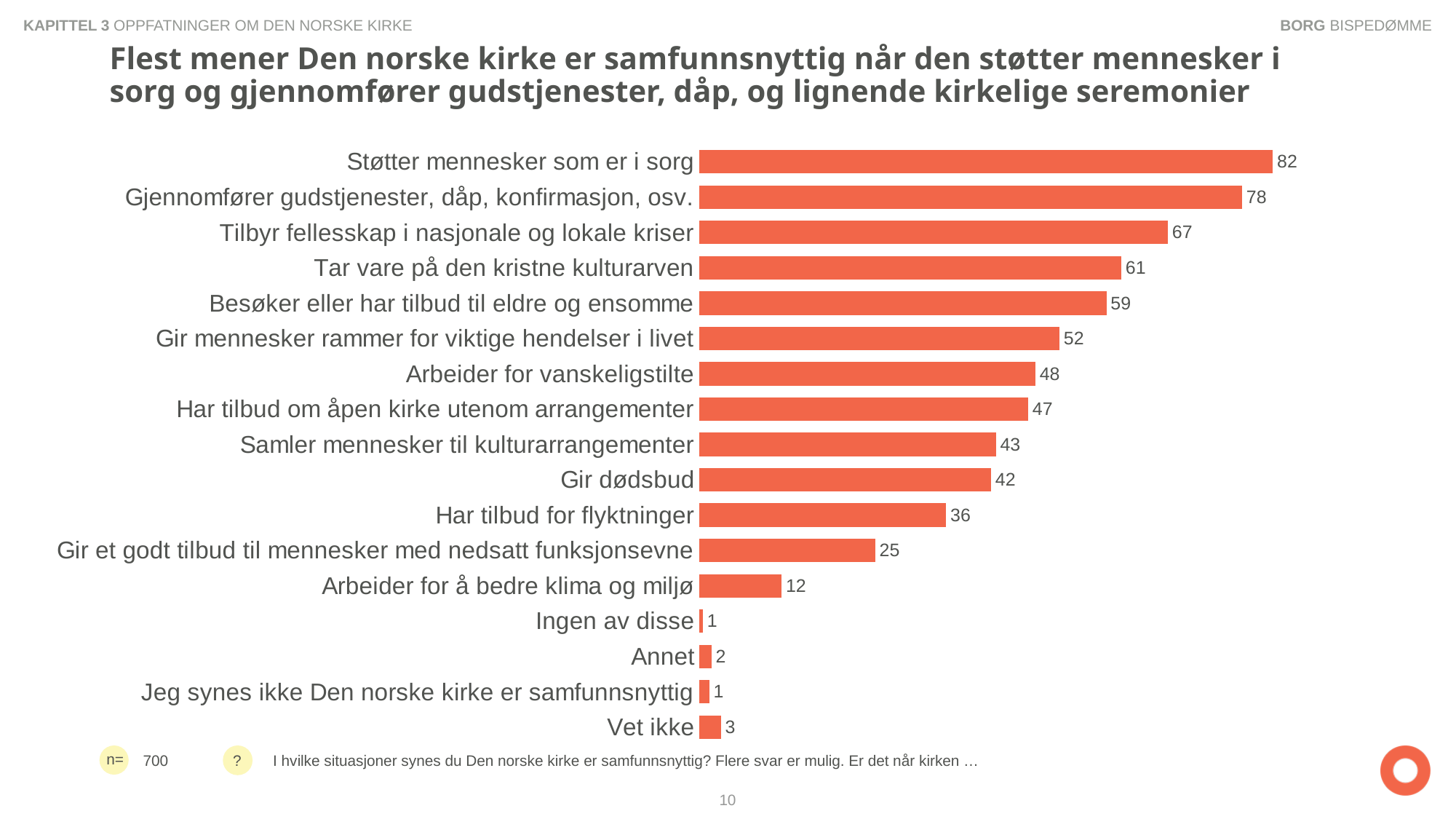
What value is shown for "Arbeider for å bedre klima og miljø"? 12 What is the difference between the values for "Tilbyr fellesskap i nasjonale og lokale kriser" and "Gir et godt tilbud til mennesker med nedsatt funksjonsevne"? 42 How many categories are shown in the chart? 17 Which category has the highest value? Støtter mennesker som er i sorg What is the difference between the values for "Støtter mennesker som er i sorg" and "Gjennomfører gudstjenester, dåp, konfirmasjon, osv."? 4 Which has a larger value, "Gir dødsbud" or "Samler mennesker til kulturarrangementer"? Samler mennesker til kulturarrangementer What value is shown for "Støtter mennesker som er i sorg"? 82 Which has a larger value, "Annet" or "Vet ikke"? Vet ikke What value is shown for "Vet ikke"? 3 What is the sample size (n) shown on the slide? 700 What value is shown for "Har tilbud for flyktninger"? 36 What kind of chart is shown on the slide? Bar chart